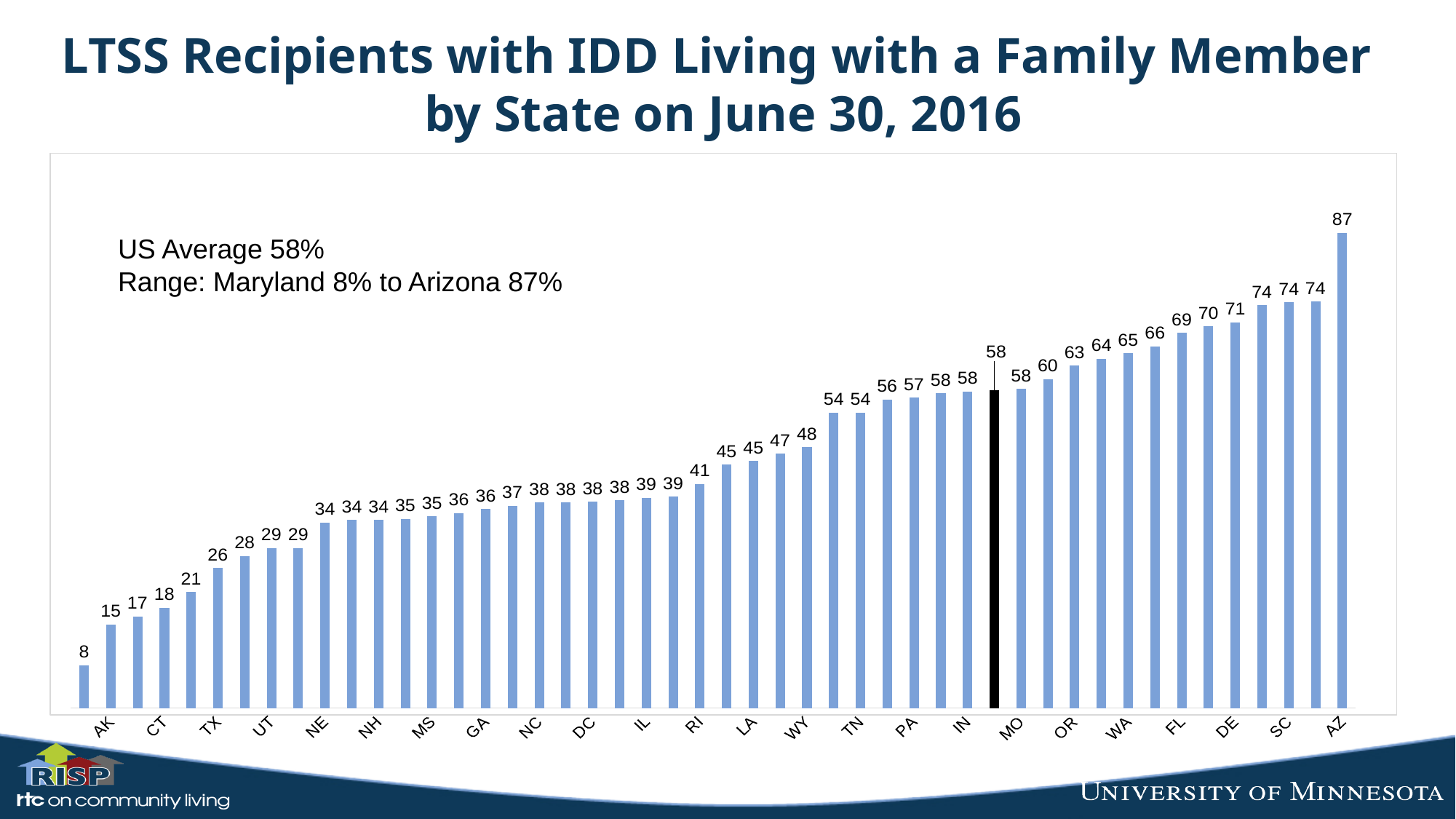
What is the difference between the values for AZ and AK? 72 What is the value for AZ? 87 Which state has the highest value? AZ What is the value for AK? 15 Do the values rise or fall from left to right along the x axis? rise Which is larger, the value for DE or the value for NC? DE What is the value for TX? 26 What US average is stated on the chart? 58% What is the value for WY? 48 What is the value for FL? 69 What kind of chart is shown? bar chart According to the text on the chart, which state has the lowest value, and what is it? Maryland, 8%